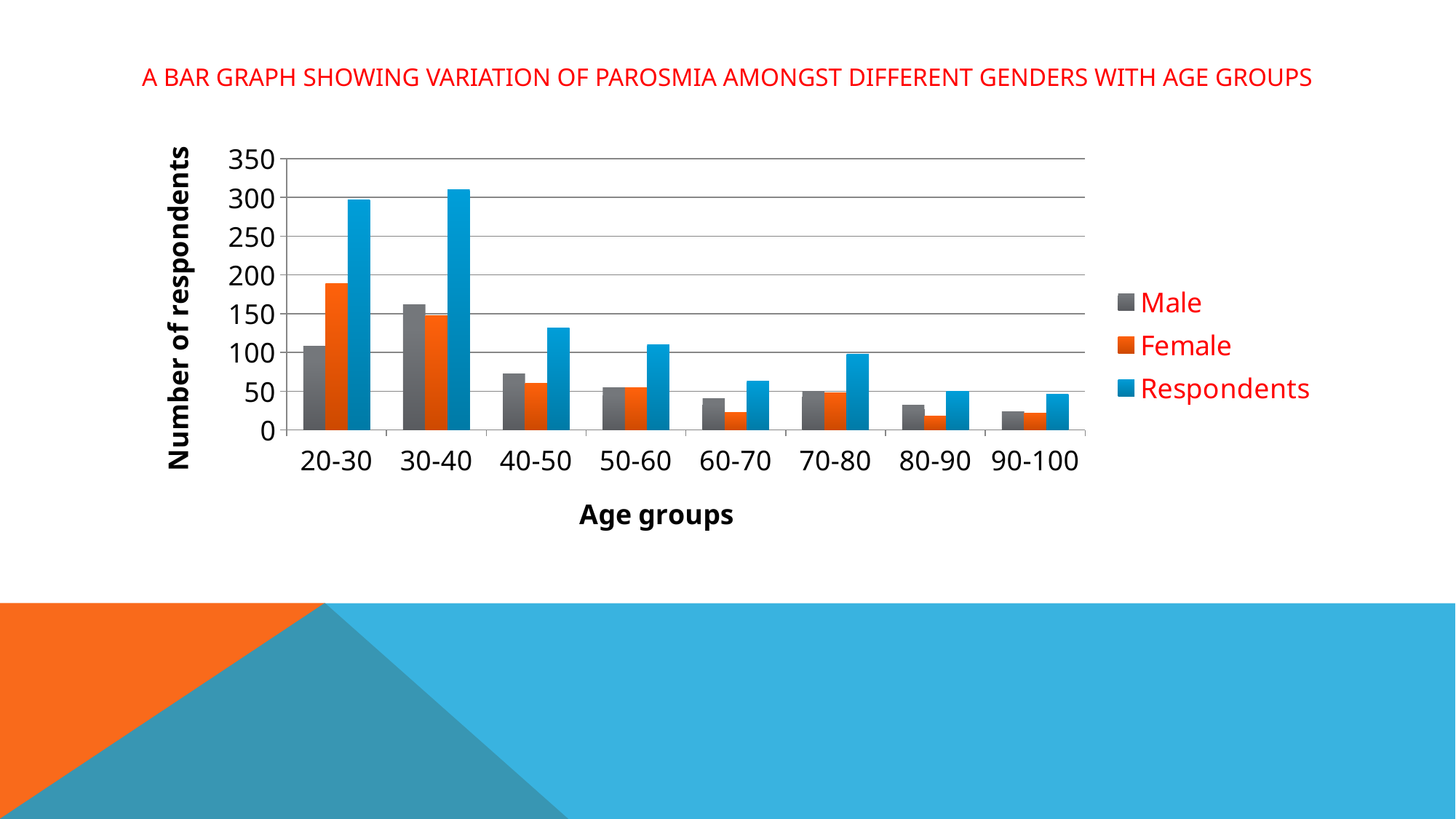
How many series does the legend list? 3 In the 20-30 age group, which is larger, the Male value or the Female value? Female Which age group has the highest Male value? 30-40 Do the Respondents values rise or fall from the 30-40 age group to the 60-70 age group? fall Is the Female value for the 20-30 age group greater or less than 150? greater Which age group has the lowest Male value? 90-100 Is the Respondents value for the 40-50 age group greater or less than 100? greater What is the label of the y axis? Number of respondents How many age groups are shown on the x axis? 8 Which age group has the highest Female value? 20-30 What kind of chart is shown on the slide? bar chart Is the Female value for the 60-70 age group greater or less than 50? less